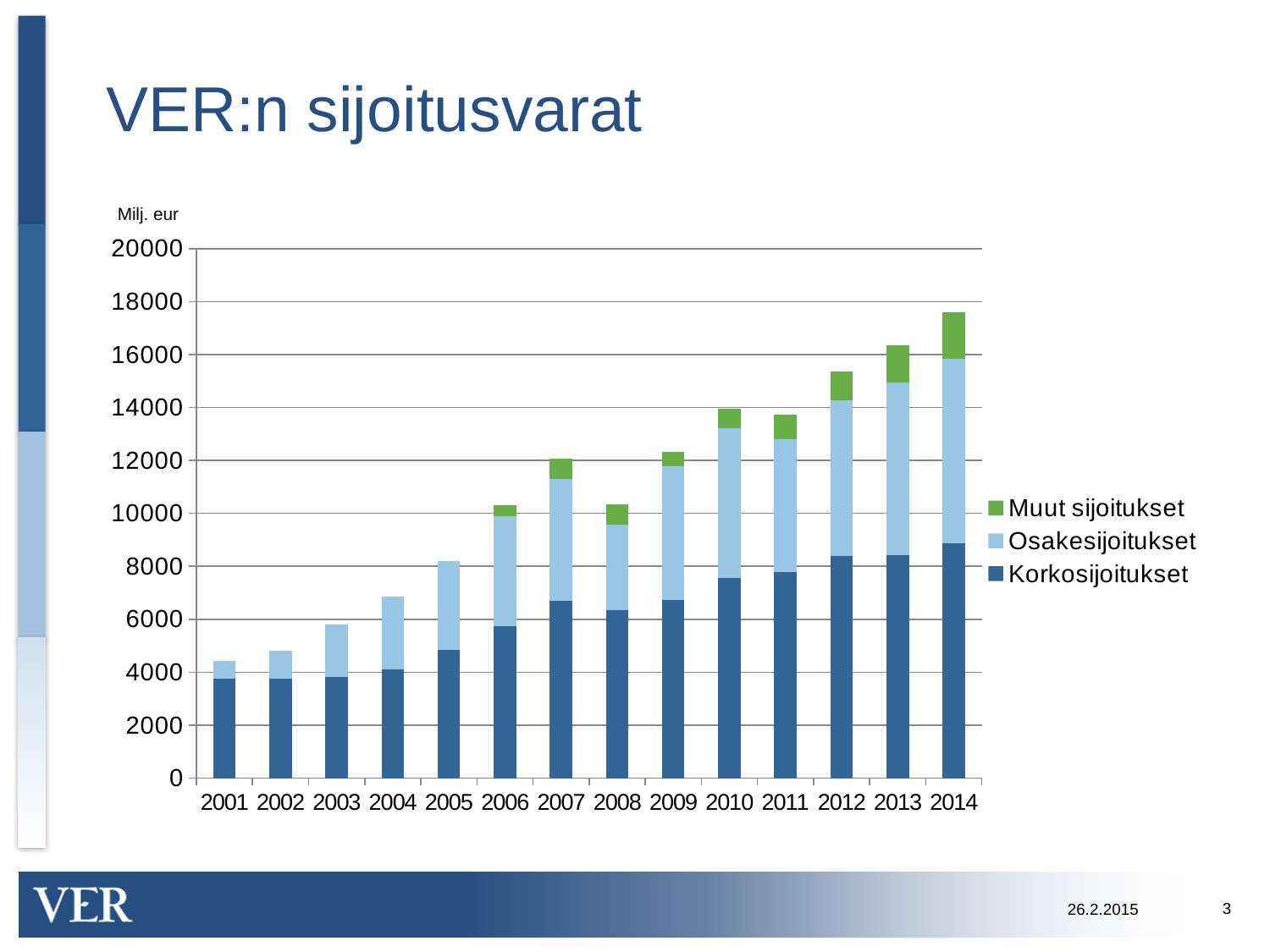
Which year has the highest total bar? 2014 What kind of chart is shown on the slide? Stacked bar chart Do the total values generally rise or fall from 2001 to 2014? Rise Is the total value for 2012 greater or less than 14000? greater Which year has a larger total bar, 2007 or 2008? 2007 Is the total value for 2014 greater or less than 16000? greater How many years are shown on the x axis? 14 Which year has the lowest total bar? 2001 What unit is shown above the y axis? Milj. eur How many series does the legend list? 3 Is the total value for 2001 greater or less than 6000? less